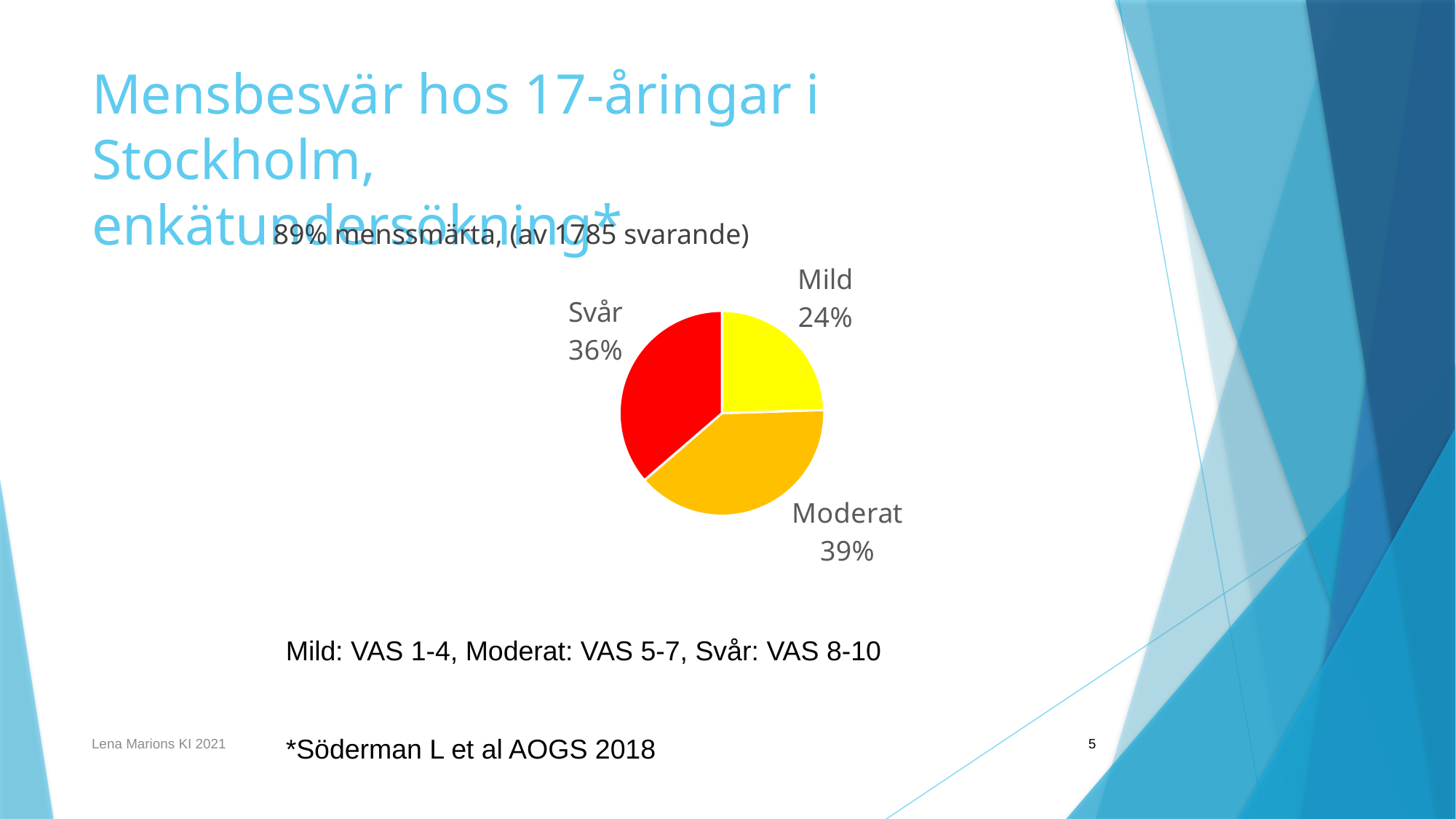
Which category has the smallest slice of the pie? Mild Which category has the largest slice of the pie? Moderat What share of the pie is labelled Moderat? 39% What is the difference in percentage points between the Moderat and Mild slices? 15 What share of the pie is labelled Svår? 36% What kind of chart is shown on the slide? pie chart Which slice is larger, Svår or Mild? Svår What colour is the Svår slice of the pie? red How many slices does the pie chart have? 3 What is the difference in percentage points between the Svår and Mild slices? 12 What is the title of the pie chart? 89% menssmärta, (av 1785 svarande) What share of the pie is labelled Mild? 24%